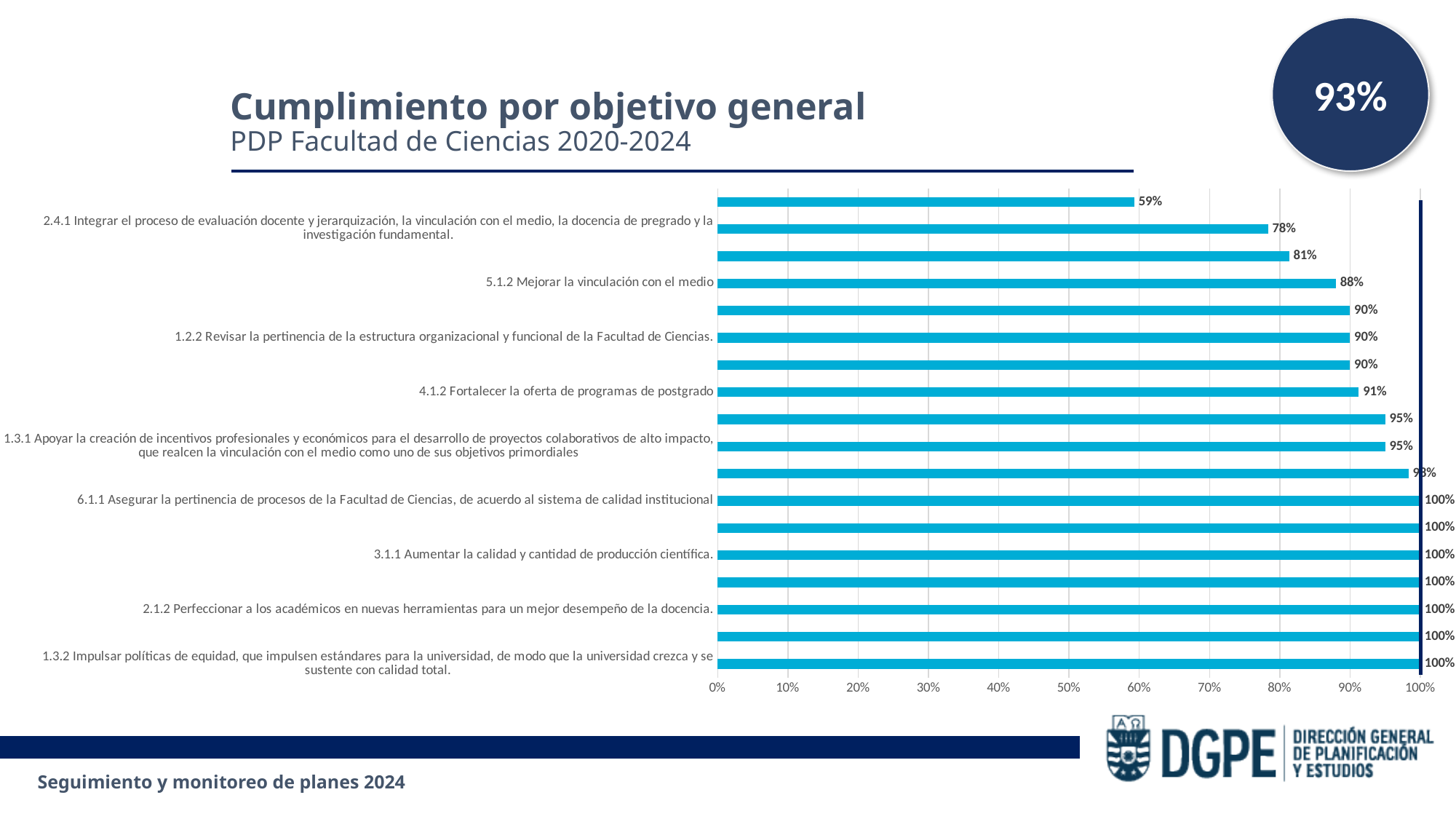
What is the lowest value shown in the chart? 59% How many bars are plotted in the chart? 18 What is the value for '4.1.2 Fortalecer la oferta de programas de postgrado'? 91% What is the value for '6.1.1 Asegurar la pertinencia de procesos de la Facultad de Ciencias...'? 100% What is the difference between the values for 4.1.2 and 5.1.2? 3 percentage points Is the value for '2.4.1 Integrar el proceso de evaluación docente...' greater or less than 80%? less What is the value for '5.1.2 Mejorar la vinculación con el medio'? 88% What is the value for '1.3.1 Apoyar la creación de incentivos profesionales y económicos...'? 95% Which has a higher value, '1.2.2 Revisar la pertinencia de la estructura organizacional...' or '1.3.1 Apoyar la creación de incentivos...'? 1.3.1 Apoyar la creación de incentivos... What is the value for '2.4.1 Integrar el proceso de evaluación docente y jerarquización...'? 78% What is the title of the chart on the slide? Cumplimiento por objetivo general What kind of chart is shown on the slide? Bar chart